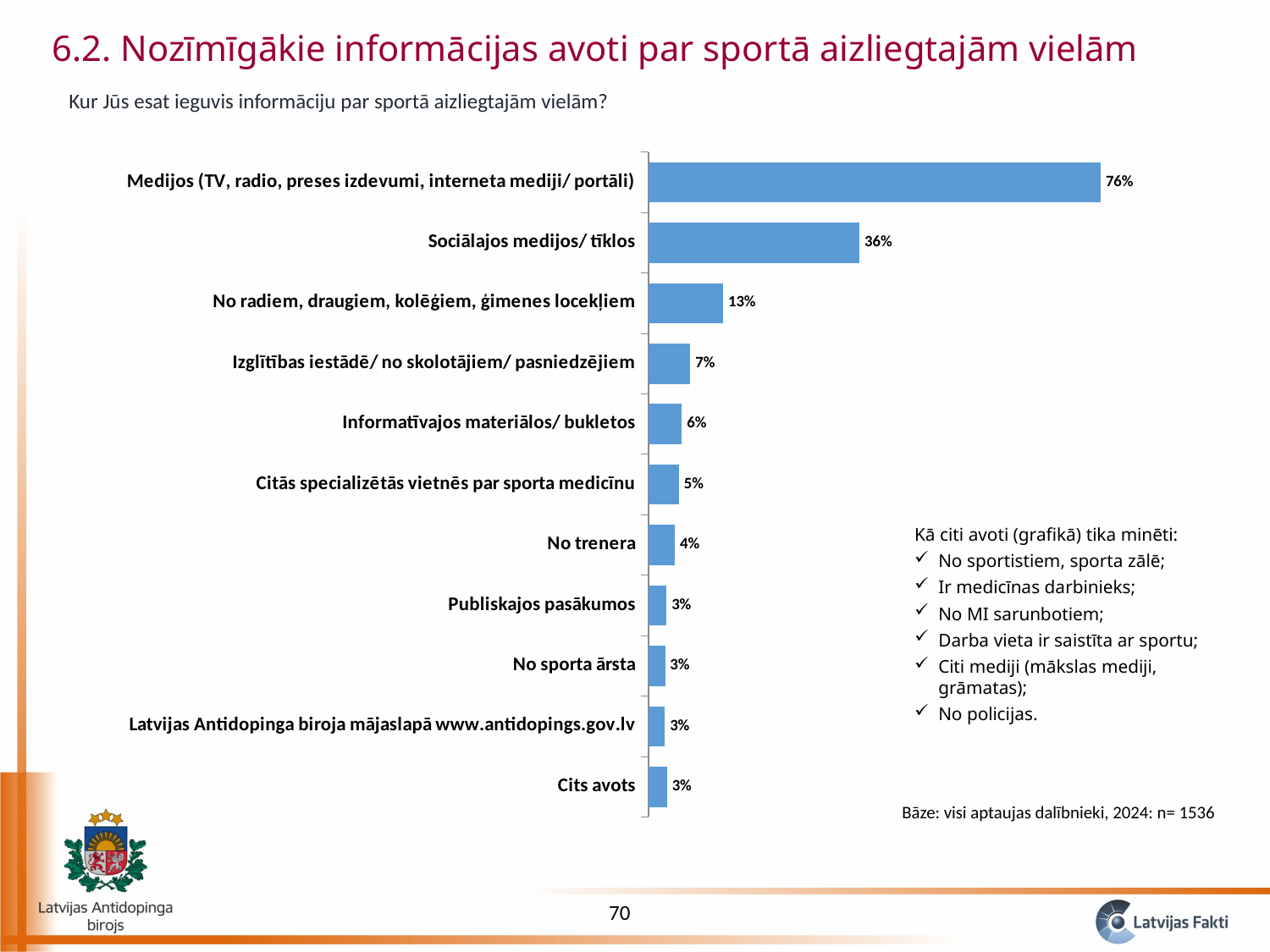
What is the value for "Sociālajos medijos/ tīklos"? 36% What is the value for "Latvijas Antidopinga biroja mājaslapā www.antidopings.gov.lv"? 3% What is the sample size stated in the base note below the chart? n= 1536 What kind of chart is shown on the slide? Bar chart Which category has the highest value? Medijos (TV, radio, preses izdevumi, interneta mediji/ portāli) What is the value for "Citās specializētās vietnēs par sporta medicīnu"? 5% What is the value for "No radiem, draugiem, kolēģiem, ģimenes locekļiem"? 13% What is the value for "No trenera"? 4% How many categories are shown in the chart? 11 What is the difference between the values for "Izglītības iestādē/ no skolotājiem/ pasniedzējiem" and "Informatīvajos materiālos/ bukletos"? 1% What is the difference between the values for "Medijos (TV, radio, preses izdevumi, interneta mediji/ portāli)" and "Sociālajos medijos/ tīklos"? 40% Which is larger, the value for "No radiem, draugiem, kolēģiem, ģimenes locekļiem" or the value for "Izglītības iestādē/ no skolotājiem/ pasniedzējiem"? No radiem, draugiem, kolēģiem, ģimenes locekļiem